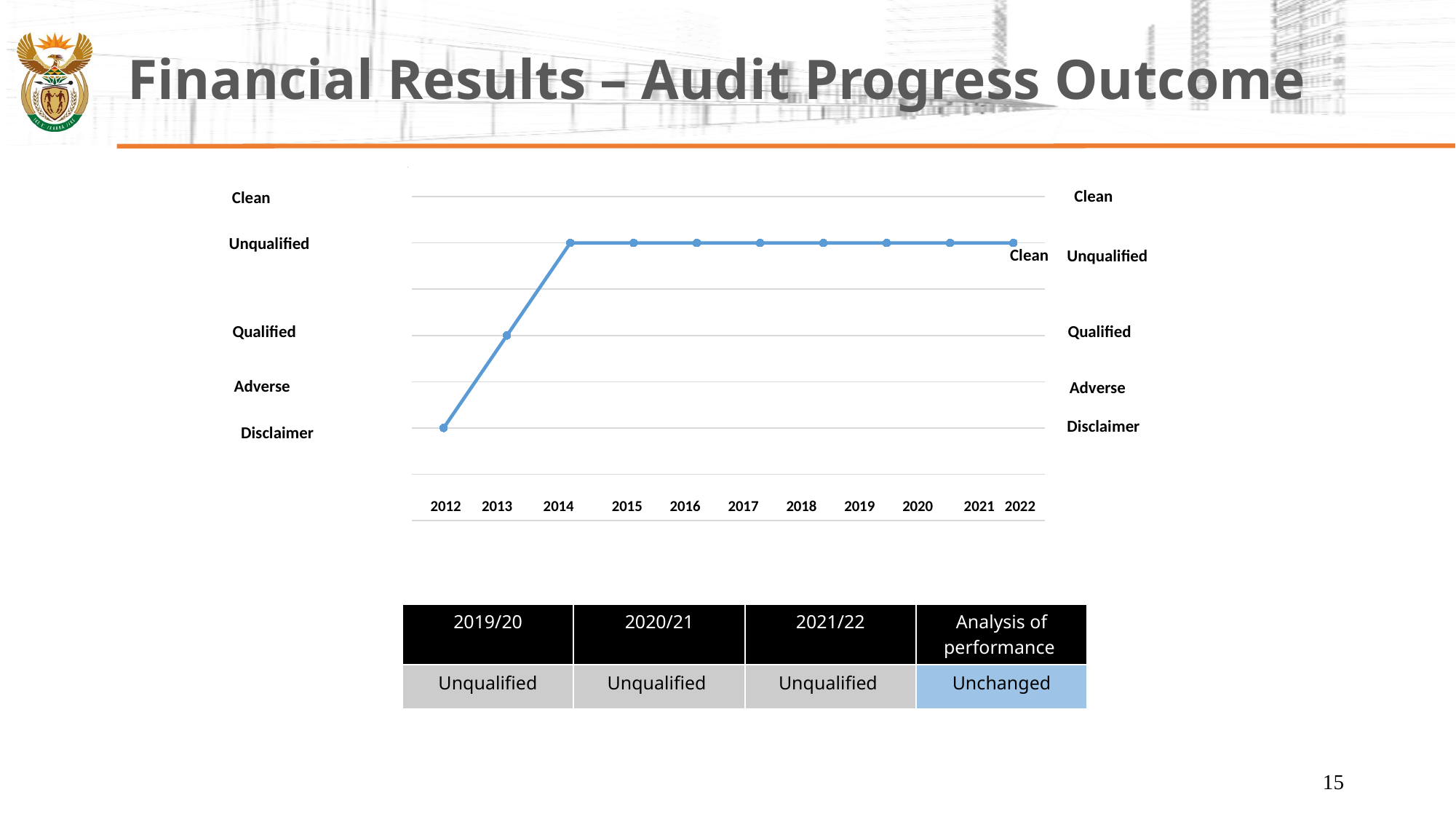
Which year has the lowest audit outcome on the chart? 2012 What is the first year shown on the x axis of the chart? 2012 What audit outcome does the chart show for 2012? Disclaimer Does the audit outcome rise or fall between 2012 and 2014? rise What audit outcome does the chart show for 2013? Qualified What audit outcome does the chart show for 2018? Unqualified What is the topmost label on the y axis of the chart? Clean Which year has the higher audit outcome on the chart, 2012 or 2013? 2013 What kind of chart is shown on the slide? line chart What audit outcome does the chart show for 2014? Unqualified